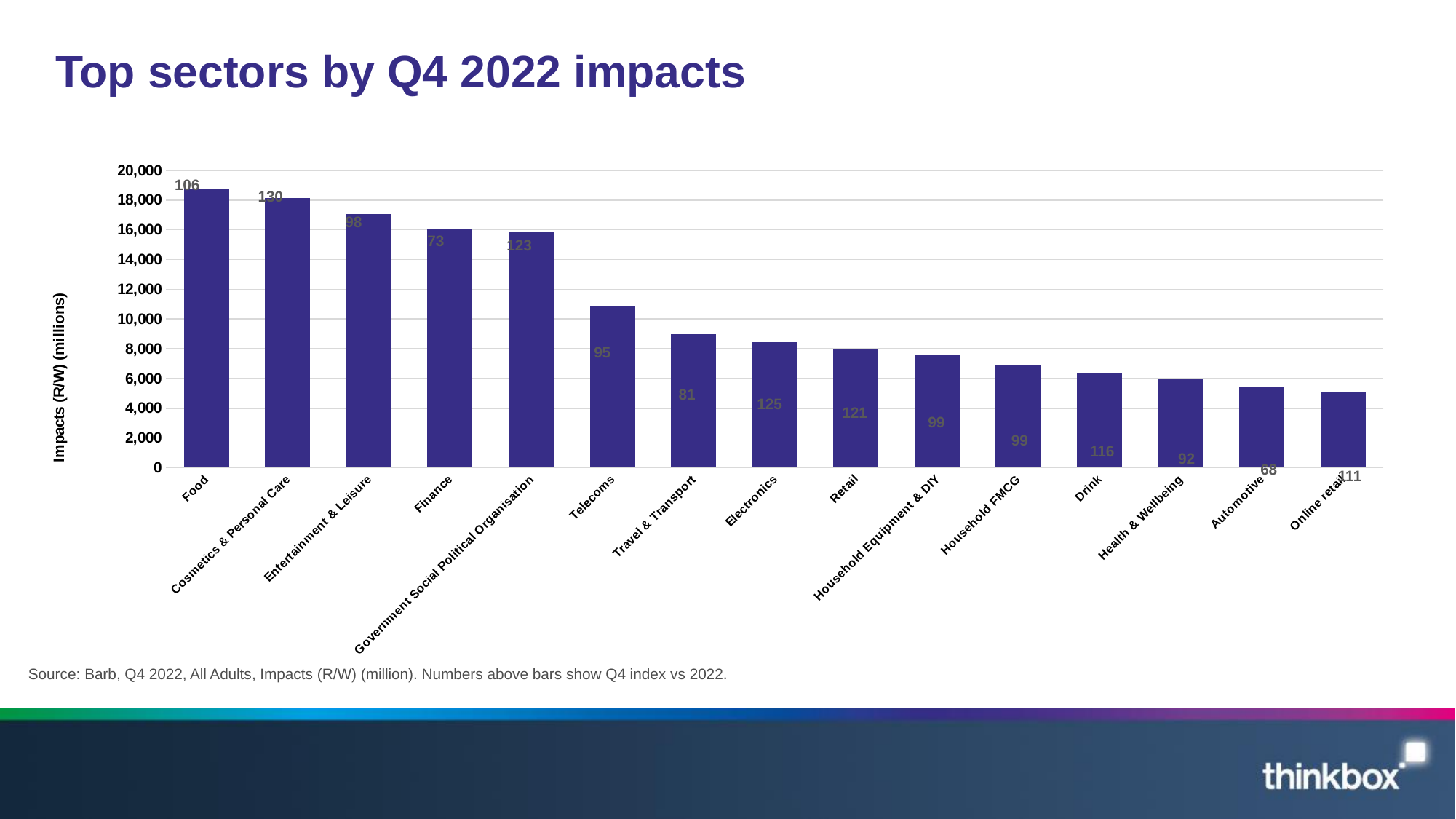
What kind of chart is shown on the slide? bar chart Which sector has the lowest Q4 2022 impacts? Online retail What Q4 index vs 2022 is printed for Cosmetics & Personal Care? 130 Is the value for Household FMCG greater or less than 8,000? less Is the value for Food greater or less than 18,000? greater Is the value for Telecoms greater or less than 10,000? greater Which has higher impacts, Finance or Electronics? Finance Do the bar values rise or fall moving from left to right along the x axis? fall Which sector has the highest Q4 2022 impacts? Food What is the label on the vertical axis? Impacts (R/W) (millions) How many sectors are plotted in the chart? 15